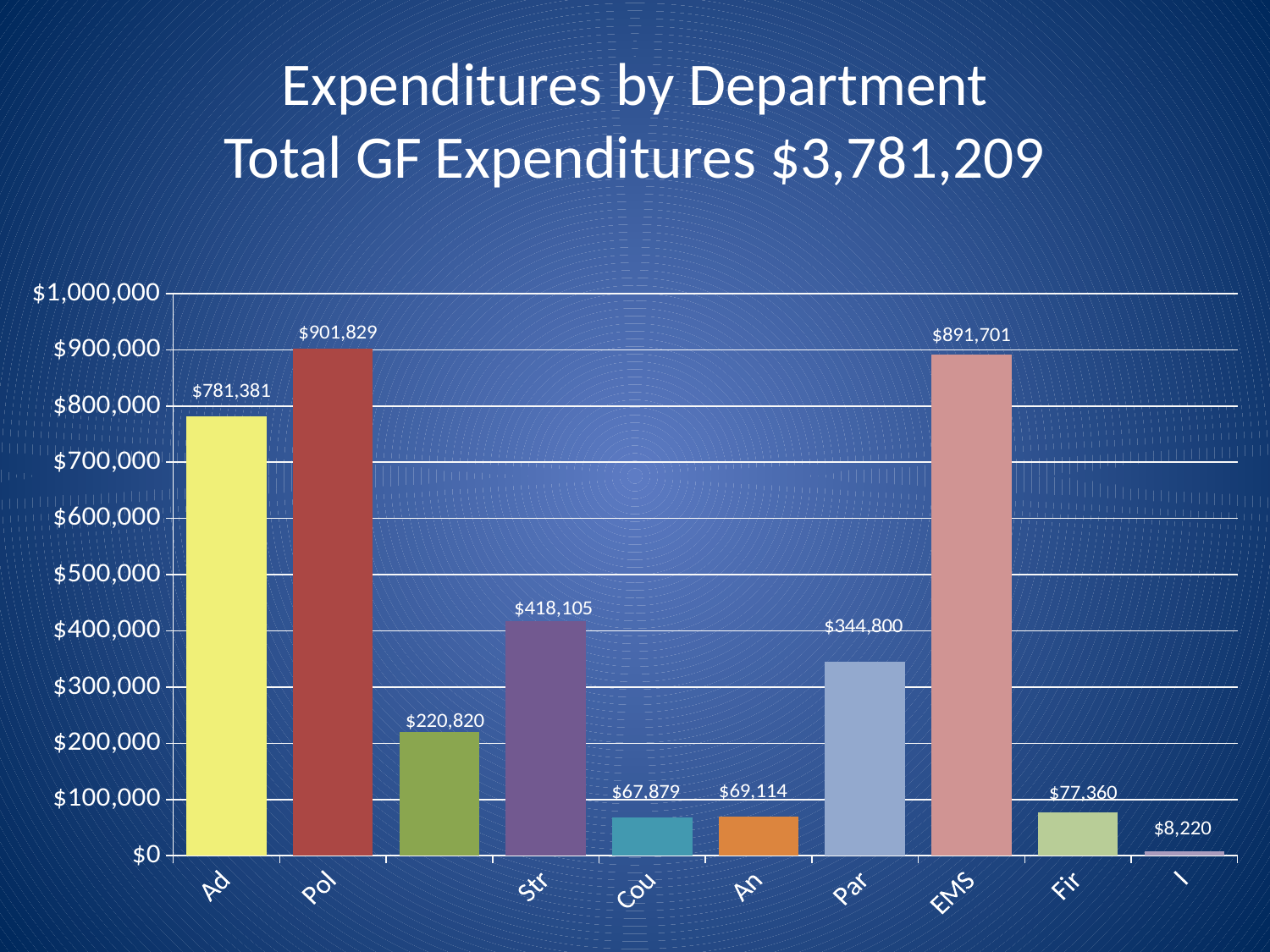
What type of chart is shown on the slide? Bar chart Which has a larger expenditure, Str or Par? Str What is the expenditure value for Pol? $901,829 What is the expenditure value for Str? $418,105 How many bars are shown in the chart? 10 Which department has the lowest expenditure? I What is the expenditure value for Fir? $77,360 Which department has the highest expenditure? Pol Is the value for Par greater or less than $300,000? greater What is the difference between the expenditures for Pol and EMS? $10,128 What is the difference between the expenditures for Ad and Str? $363,276 What is the expenditure value for EMS? $891,701